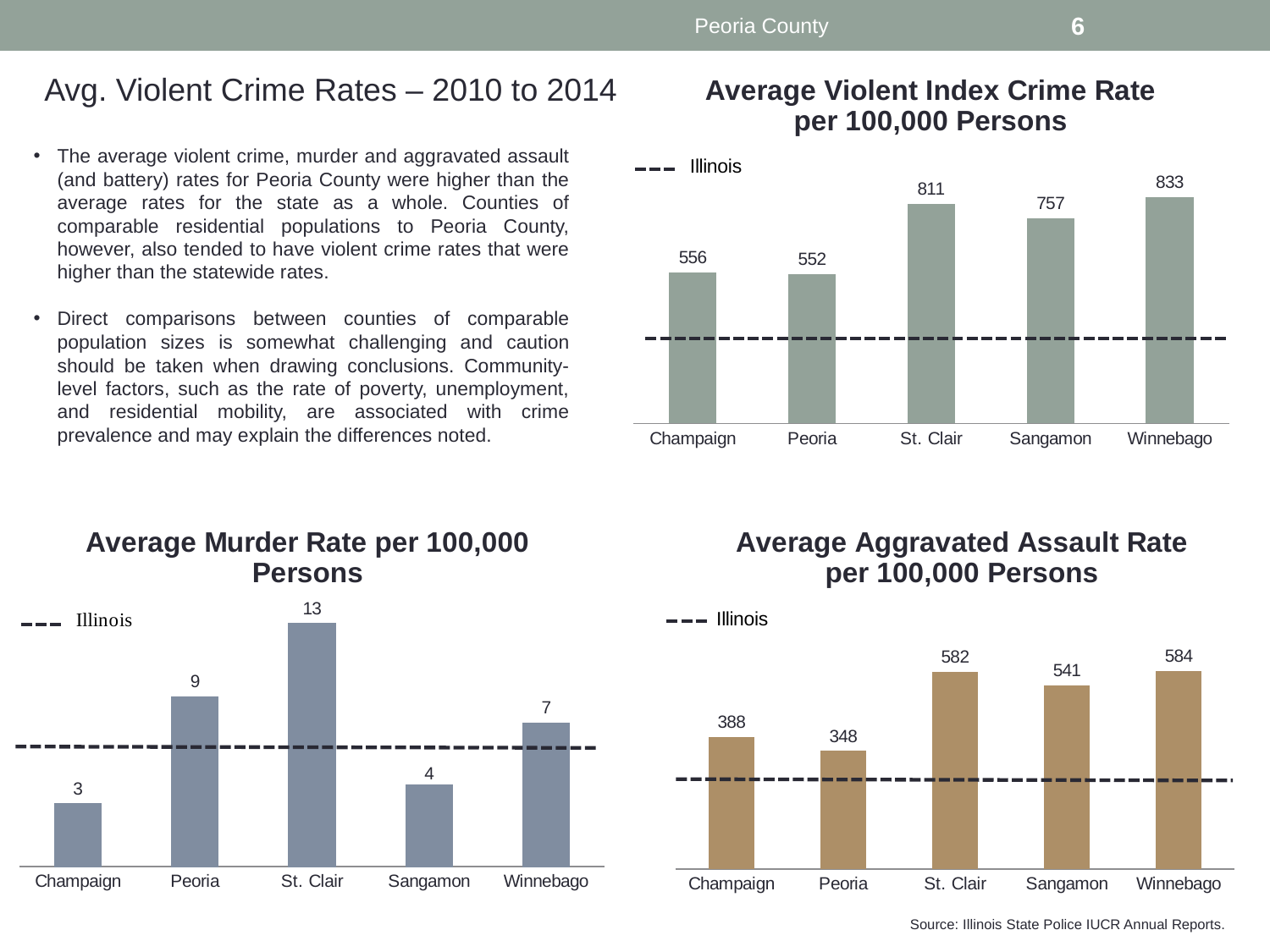
In the 'Average Murder Rate per 100,000 Persons' chart, what is the difference between Peoria and Champaign? 6 In the 'Average Murder Rate per 100,000 Persons' chart, which county has the highest value? St. Clair In the 'Average Murder Rate per 100,000 Persons' chart, what is the value for St. Clair? 13 In the 'Average Murder Rate per 100,000 Persons' chart, which is larger, Peoria or Winnebago? Peoria In the 'Average Violent Index Crime Rate per 100,000 Persons' chart, what is the difference between Winnebago and Champaign? 277 In the 'Average Violent Index Crime Rate per 100,000 Persons' chart, which county has the lowest value? Peoria In the 'Average Aggravated Assault Rate per 100,000 Persons' chart, which county has the lowest value? Peoria In the 'Average Violent Index Crime Rate per 100,000 Persons' chart, what is the value for Peoria? 552 In the 'Average Aggravated Assault Rate per 100,000 Persons' chart, what is the value for Sangamon? 541 In the 'Average Violent Index Crime Rate per 100,000 Persons' chart, how many counties are shown on the x axis? 5 What kind of chart is the 'Average Aggravated Assault Rate per 100,000 Persons' chart? Bar chart In the 'Average Aggravated Assault Rate per 100,000 Persons' chart, what does the dashed line represent according to the legend? Illinois